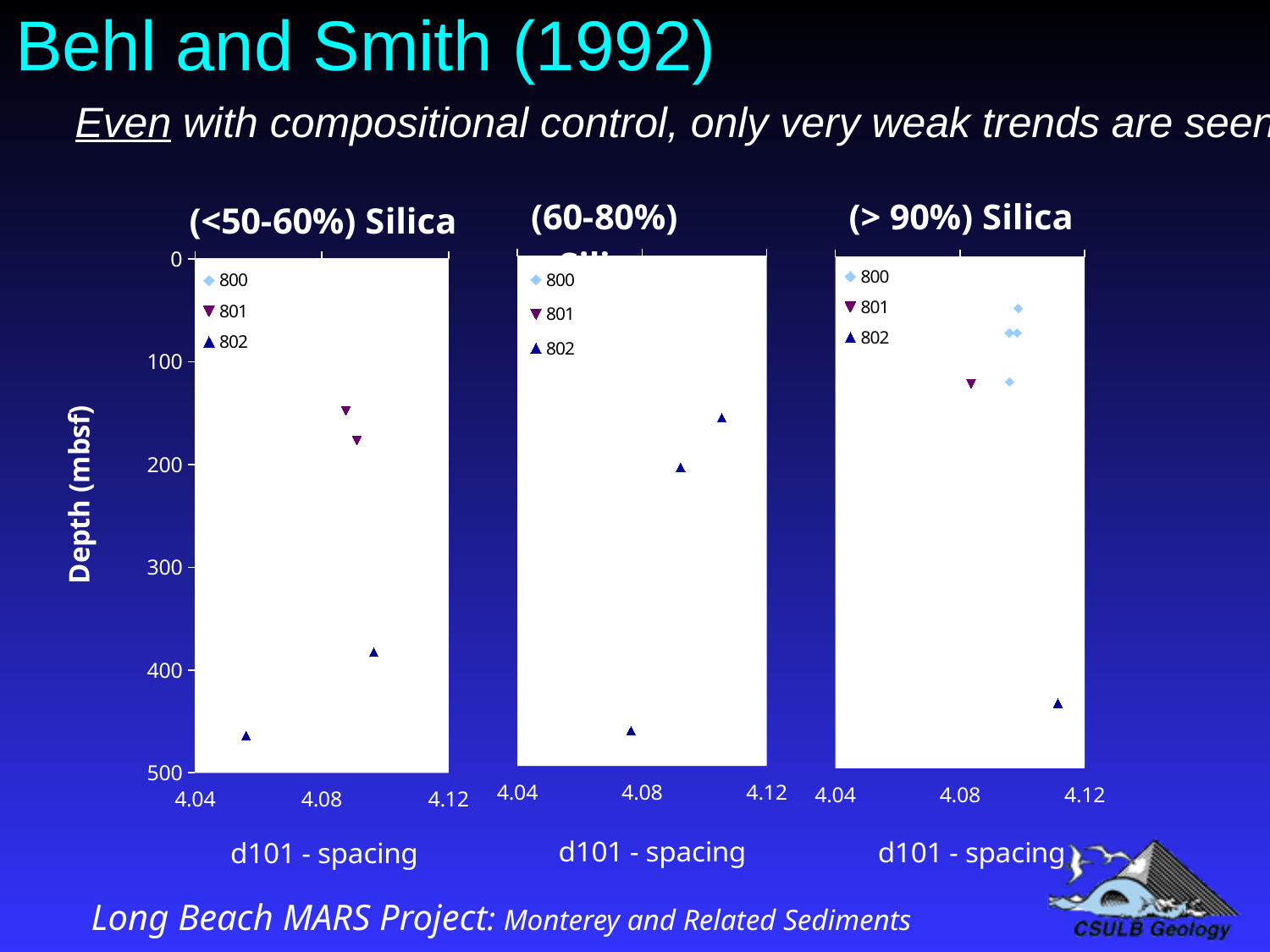
How many series does the legend of the "(> 90%) Silica" chart list? 3 In the "(<50-60%) Silica" chart, is the depth of the deepest 802 point greater or less than 400? greater What is the label on the shared y axis of the three charts? Depth (mbsf) What is the label on the x axis of the "(60-80%) Silica" chart? d101 - spacing How many data points are plotted in the "(60-80%) Silica" chart? 3 How many data points are plotted in the "(<50-60%) Silica" chart? 4 In the "(<50-60%) Silica" chart, which series is plotted at greater depths, 801 or 802? 802 In the "(60-80%) Silica" chart, is the depth of the deepest 802 point greater or less than 400? greater In the "(> 90%) Silica" chart, is the d101 - spacing of the 802 point greater or less than 4.08? greater What kind of chart is the "(<50-60%) Silica" chart? scatter chart How many 801 points are plotted in the "(> 90%) Silica" chart? 1